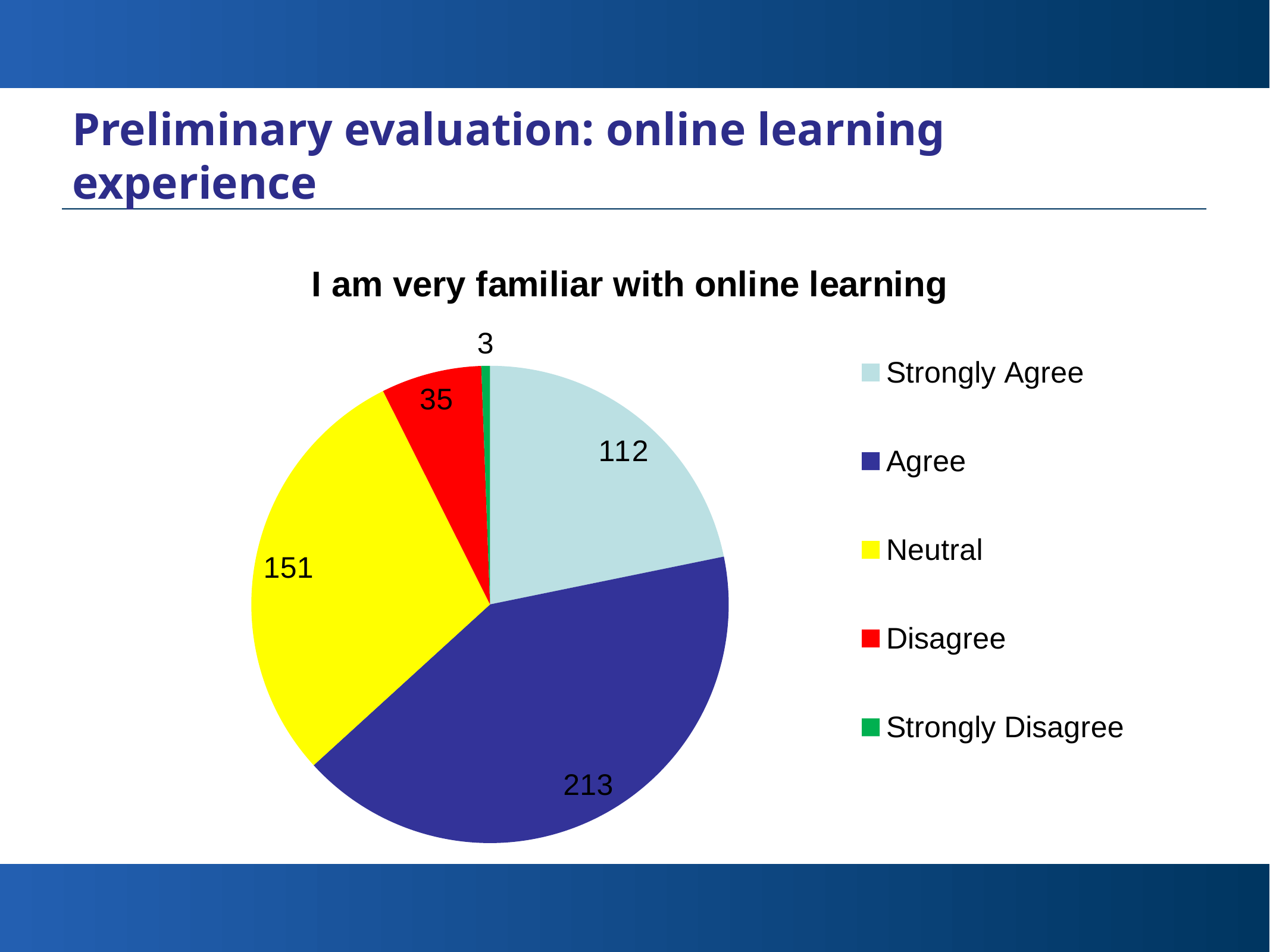
What is the value for Strongly Agree? 112 Which is larger, the value for Neutral or the value for Strongly Agree? Neutral What colour is the Disagree slice? red What is the value for Neutral? 151 What is the difference between the values for Agree and Neutral? 62 What type of chart is shown on the slide? pie chart What is the value for Agree? 213 Which category has the largest slice? Agree Which category has the smallest slice? Strongly Disagree How many categories does the legend list? 5 What is the value for Strongly Disagree? 3 What is the title of the chart? I am very familiar with online learning